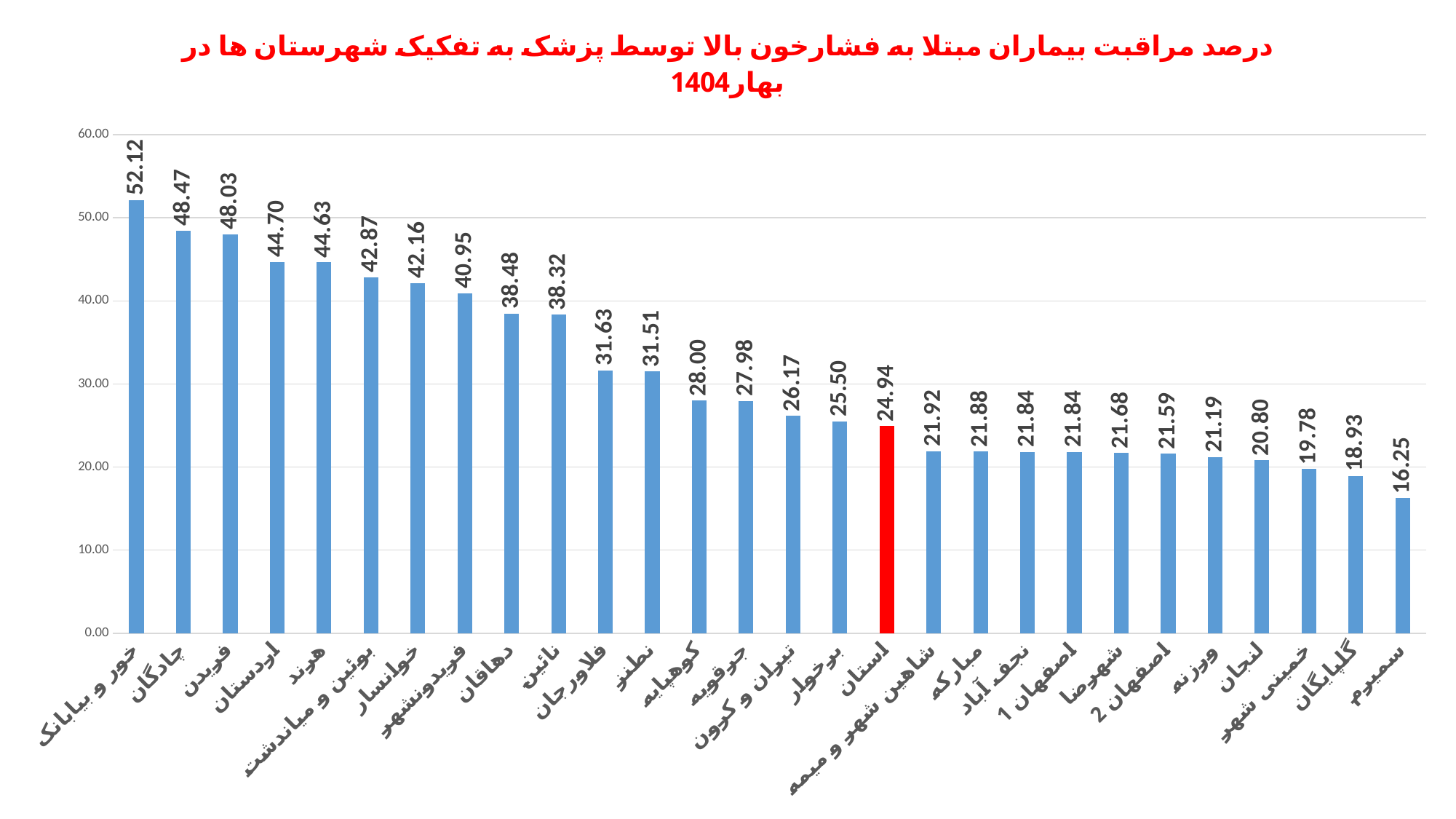
What is the value for استان (the red bar)? 24.94 What is the value for خور و بیابانک? 52.12 Which category has the lowest value? سمیرم How many bars are shown in the chart? 28 Which is larger, the value for دهاقان or the value for فلاورجان? دهاقان What is the difference between the values for چادگان and فریدن? 0.44 What kind of chart is shown on the slide? bar chart Which category has the highest value? خور و بیابانک Is the value for خوانسار greater or less than 40.00? greater What is the difference between the values for استان and سمیرم? 8.69 Which bar is coloured red instead of blue? استان What is the value for نطنز? 31.51